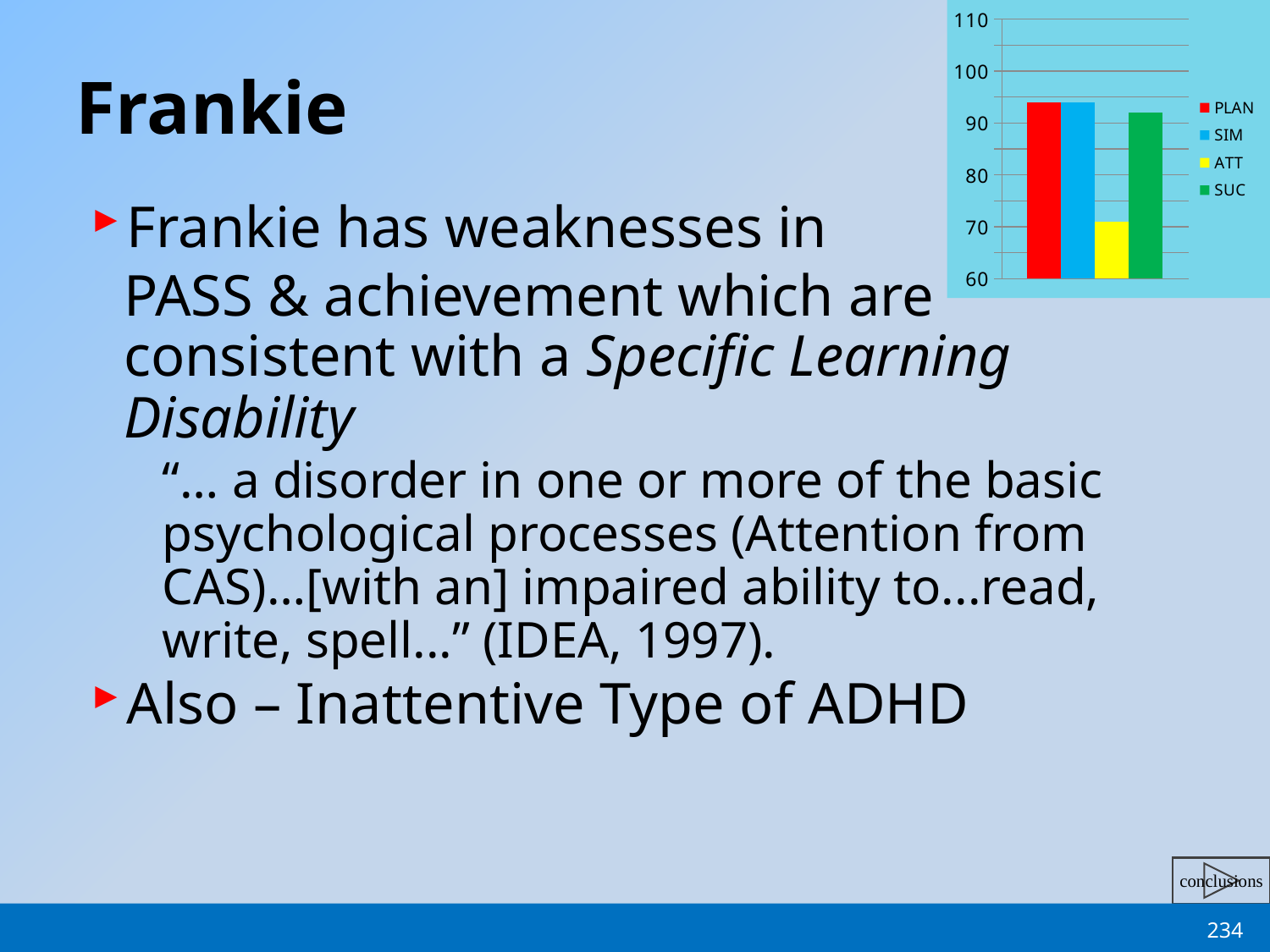
Is the value for PLAN greater or less than 90? greater Is the value for SUC greater or less than 80? greater Is the value for PLAN greater or less than 100? less How many series does the chart legend list? 4 What is the lowest value shown on the chart's vertical axis? 60 What colour represents the ATT series in the chart? yellow What kind of chart is shown on the slide? bar chart Which is larger, the value for PLAN or the value for ATT? PLAN Which is larger, the value for ATT or the value for SUC? SUC Which series has the lowest value in the chart? ATT